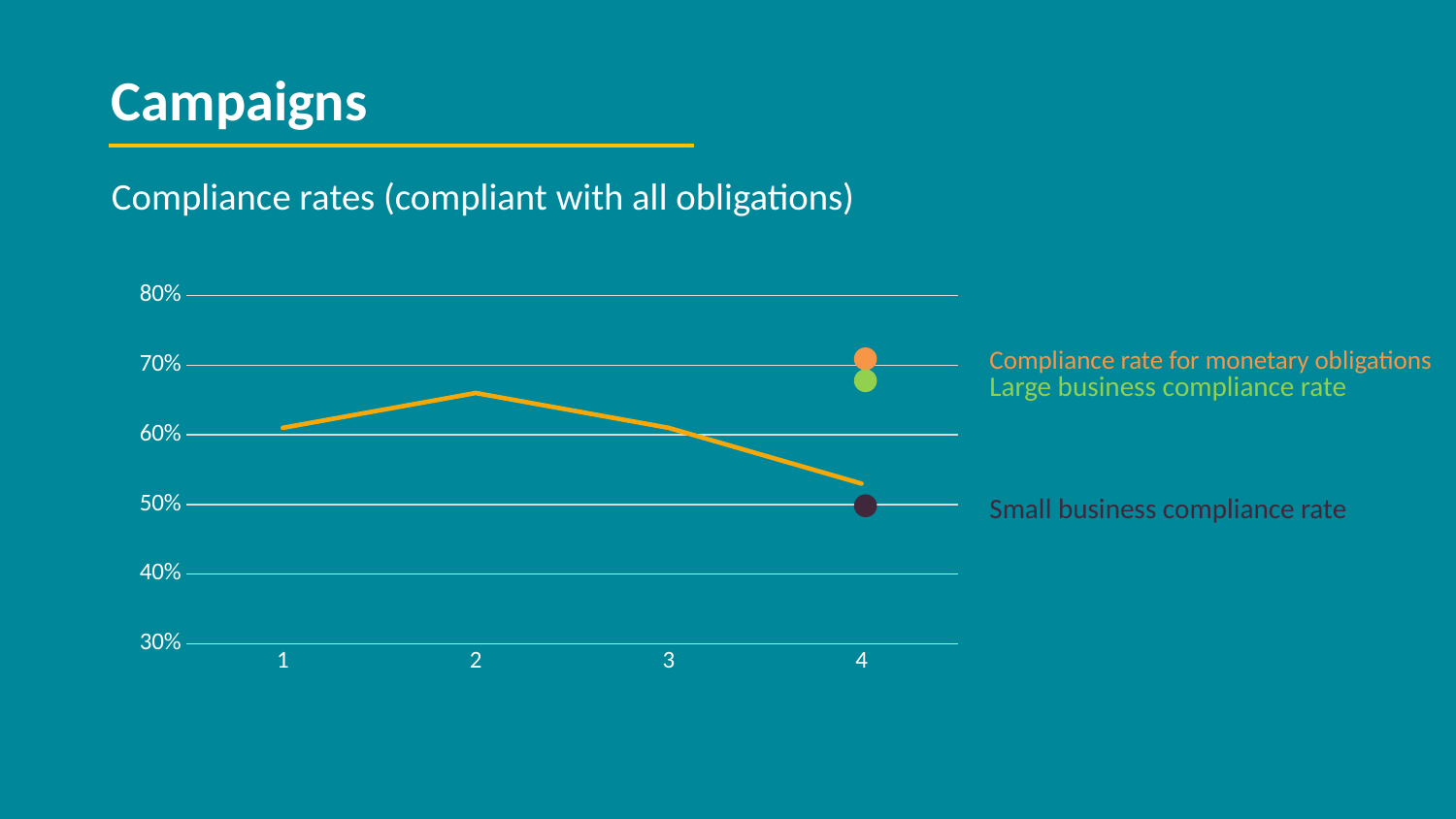
Which of the markers at point 4 is the lowest: Compliance rate for monetary obligations, Large business compliance rate, or Small business compliance rate? Small business compliance rate What is the title of the chart? Compliance rates (compliant with all obligations) Is the value of the orange line at point 2 greater or less than 70%? less Which is larger: the orange line's value at point 2 or at point 4? point 2 At which x-axis point does the orange line reach its highest value? 2 Is the value of the orange line at point 2 greater or less than 60%? greater How many points are plotted along the x axis of the orange line? 4 Is the value of the orange line at point 4 greater or less than 60%? less At which x-axis point does the orange line reach its lowest value? 4 What kind of chart is shown on the slide? line chart Does the orange line rise or fall between points 2 and 4? fall